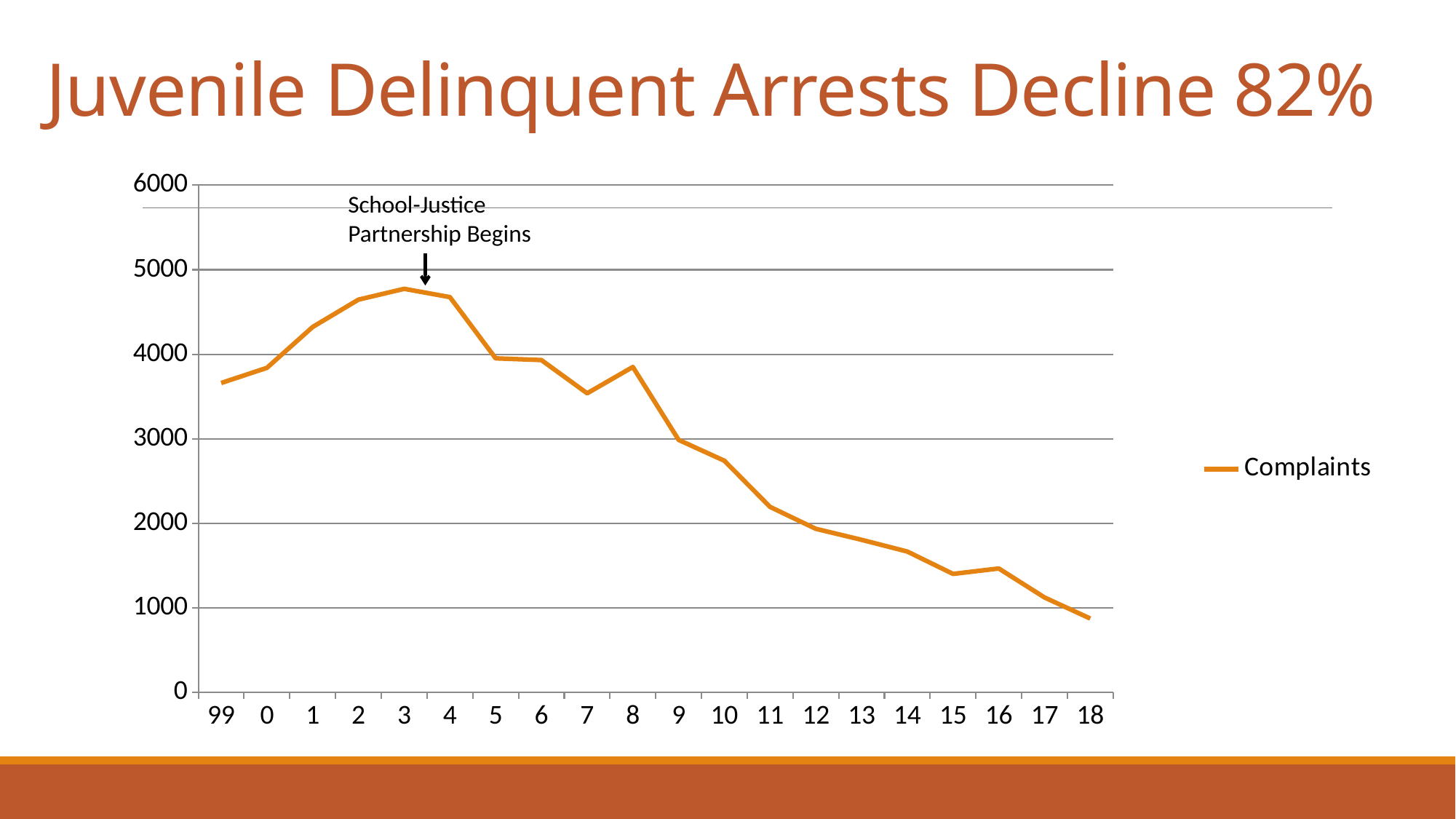
How many points are plotted along the x axis? 20 What kind of chart is shown on the slide? line chart Which has the larger value, 3 or 18? 3 Do the Complaints values rise or fall along the x axis from 3 to 18? fall Is the value for 15 greater or less than 2000? less What is the name of the series shown in the legend? Complaints At which x-axis label does the Complaints line reach its highest value? 3 What event does the annotation with the arrow on the chart mark? School-Justice Partnership Begins At which x-axis label does the Complaints line reach its lowest value? 18 How many series does the legend list? 1 Is the value for 18 greater or less than 1000? less Is the value for 99 greater or less than 3000? greater